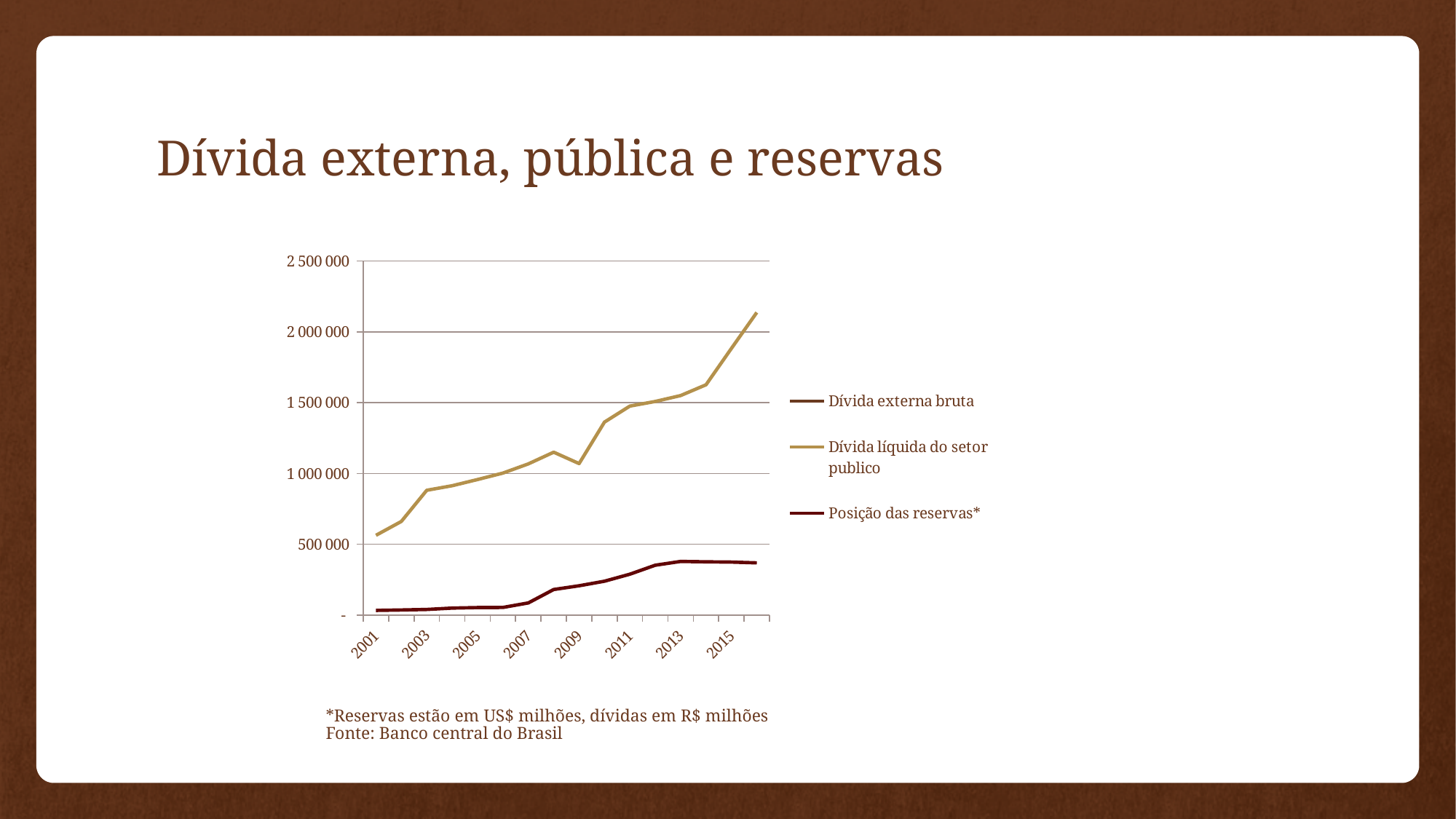
What kind of chart is shown on the slide? line chart Is the value of Dívida líquida do setor publico in 2015 greater or less than 1 500 000? greater Is the value of Dívida líquida do setor publico in 2001 greater or less than 1 000 000? less Is the value of Dívida líquida do setor publico in 2005 greater or less than 1 500 000? less Which is larger for Dívida líquida do setor publico: the value in 2009 or the value in 2011? 2011 According to the footnote, what is the source of the chart data? Banco central do Brasil Does the Dívida líquida do setor publico line generally rise or fall from 2001 onward? rise What is the title of the slide containing the chart? Dívida externa, pública e reservas How many year labels are printed along the x axis? 8 How many series does the chart legend list? 3 What is the highest value labelled on the y axis? 2 500 000